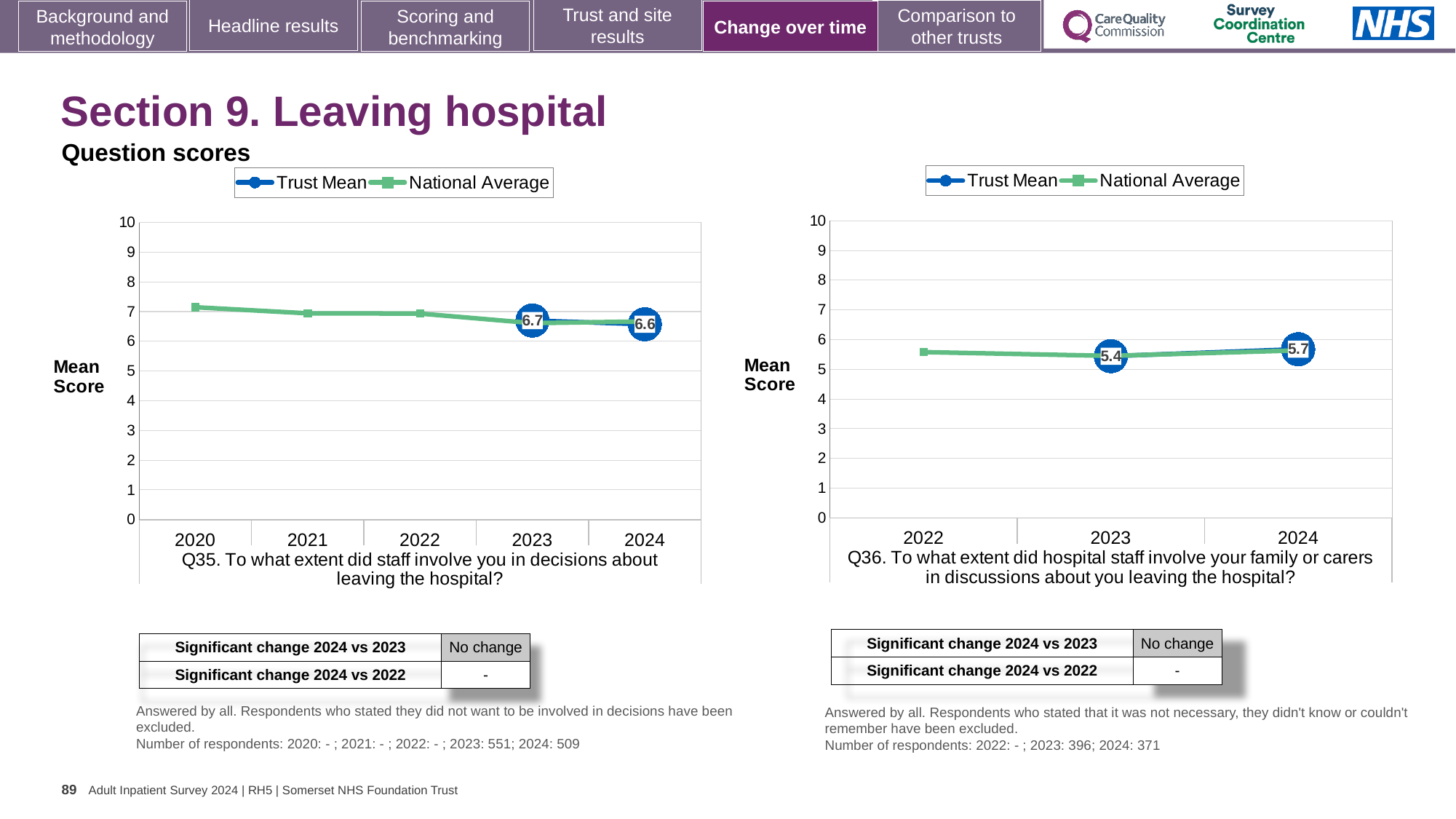
In the Q35 chart on the left, what is the Trust Mean score for 2023? 6.7 In the Q35 chart on the left, what is the Trust Mean score for 2024? 6.6 In the Q36 chart on the right, does the Trust Mean rise or fall from 2023 to 2024? Rise In the Q36 chart on the right, what is the Trust Mean score for 2023? 5.4 In the Q36 chart on the right, what is the Trust Mean score for 2024? 5.7 In the Q36 chart on the right, which year has the higher Trust Mean, 2023 or 2024? 2024 How many years are shown on the x axis of the Q35 chart on the left? 5 In the Q36 chart on the right, is the National Average for 2022 greater or less than 5? greater In the Q36 chart on the right, by how much did the Trust Mean change from 2023 to 2024? 0.3 In the Q35 chart on the left, what is the difference between the Trust Mean for 2023 and 2024? 0.1 How many series does the legend of the Q36 chart on the right list? 2 What type of chart is used for the Q35 chart on the left? Line chart